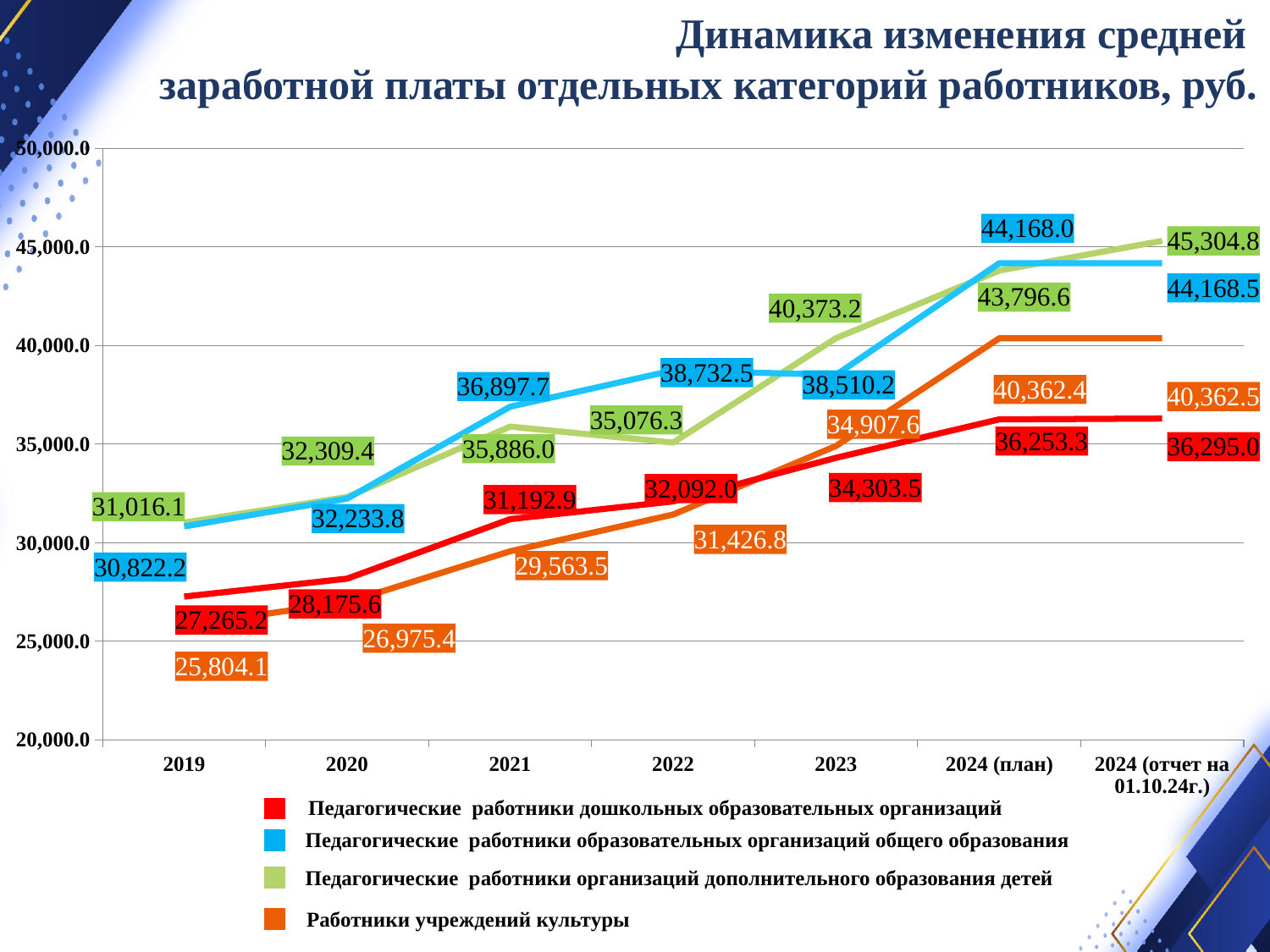
What is the value for Работники учреждений культуры in 2022? 31,426.8 What is the value for Педагогические работники образовательных организаций общего образования in 2021? 36,897.7 In 2022, which is larger: the value for Педагогические работники образовательных организаций общего образования or for Педагогические работники организаций дополнительного образования детей? Педагогические работники образовательных организаций общего образования What is the difference between the 2023 values for Педагогические работники организаций дополнительного образования детей and Педагогические работники дошкольных образовательных организаций? 6,069.7 What type of chart is shown on the slide? Line chart Does the value for Работники учреждений культуры rise or fall from 2019 to 2024 (план)? Rise What is the value for Педагогические работники организаций дополнительного образования детей in 2024 (отчет на 01.10.24г.)? 45,304.8 What is the value for Педагогические работники дошкольных образовательных организаций in 2019? 27,265.2 How many categories are shown along the x axis? 7 Which series has the lowest value in 2019? Работники учреждений культуры How many series does the legend list? 4 Which series has the highest value in 2024 (отчет на 01.10.24г.)? Педагогические работники организаций дополнительного образования детей